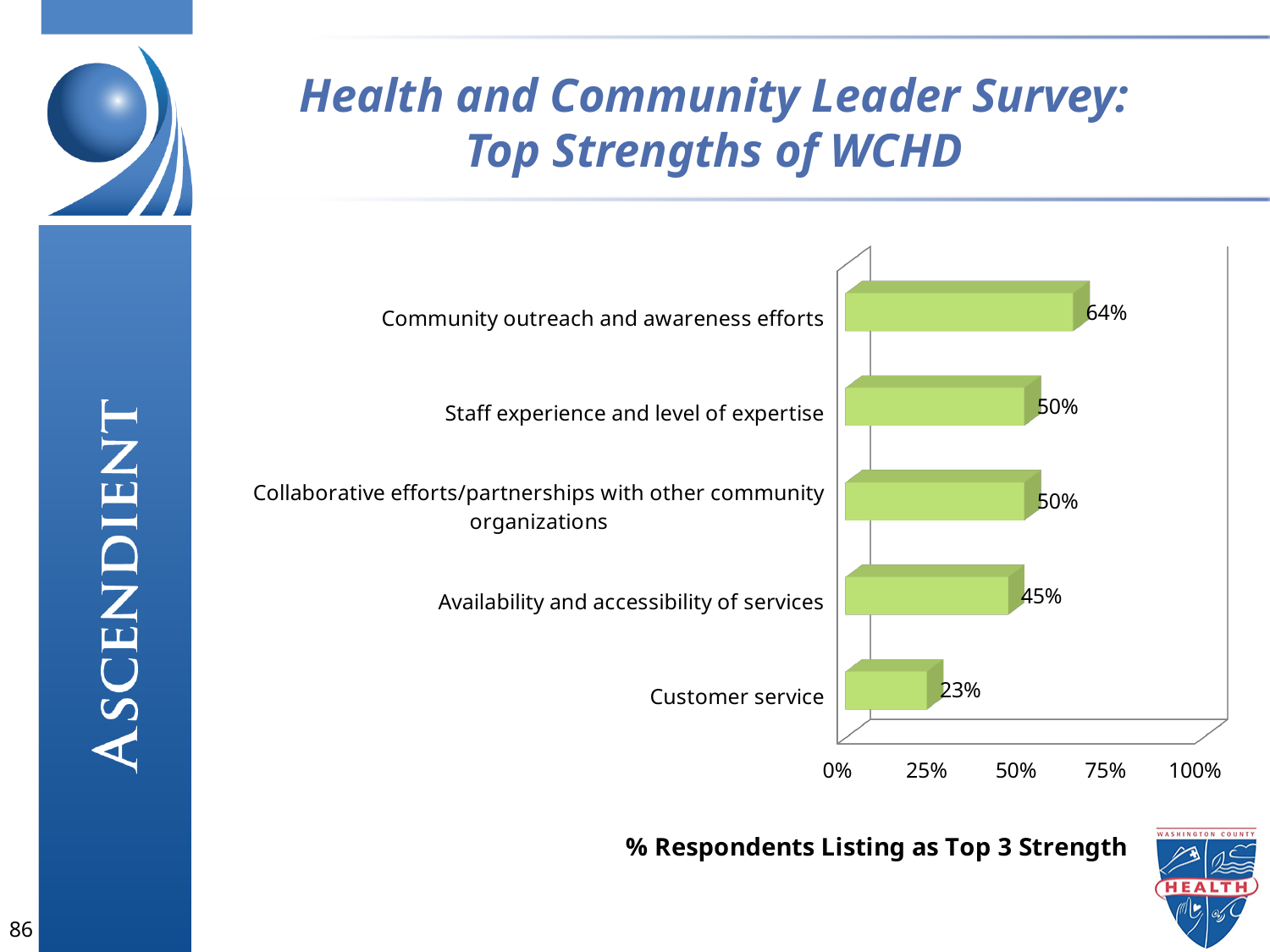
What is the value for Staff experience and level of expertise? 50% Which category has the highest value? Community outreach and awareness efforts What is the label shown below the chart's x axis? % Respondents Listing as Top 3 Strength How many categories are shown in the chart? 5 Which is larger: the value for Availability and accessibility of services or the value for Customer service? Availability and accessibility of services Is the value for Community outreach and awareness efforts greater or less than 50%? greater What percentage of respondents listed Community outreach and awareness efforts as a top 3 strength? 64% What is the value for Availability and accessibility of services? 45% What kind of chart is shown on the slide? Bar chart What is the difference between the values for Community outreach and awareness efforts and Customer service? 41% What is the value for Customer service? 23% Which category has the lowest value? Customer service